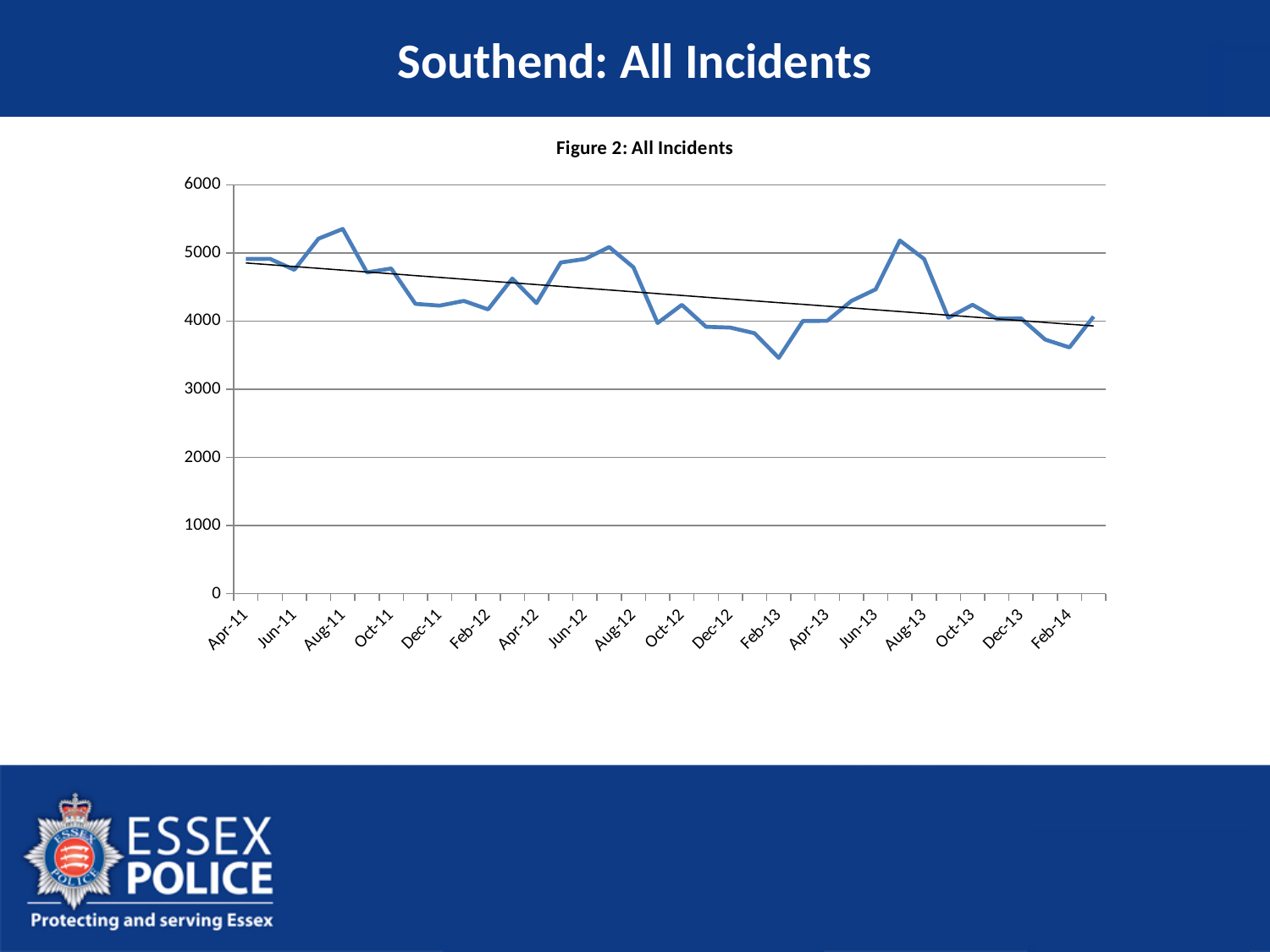
What is the title of the chart? Figure 2: All Incidents How many month labels are shown on the x axis? 18 Does the overall trend of incidents rise or fall from Apr-11 to Feb-14? fall Which is larger, the value for Aug-11 or the value for Feb-13? Aug-11 Is the value for Aug-11 greater or less than 5000? greater Which is larger, the value for Apr-11 or the value for Feb-14? Apr-11 Is the value for Feb-13 greater or less than 4000? less What kind of chart is shown on the slide? line chart Is the value for Dec-11 greater or less than 4000? greater